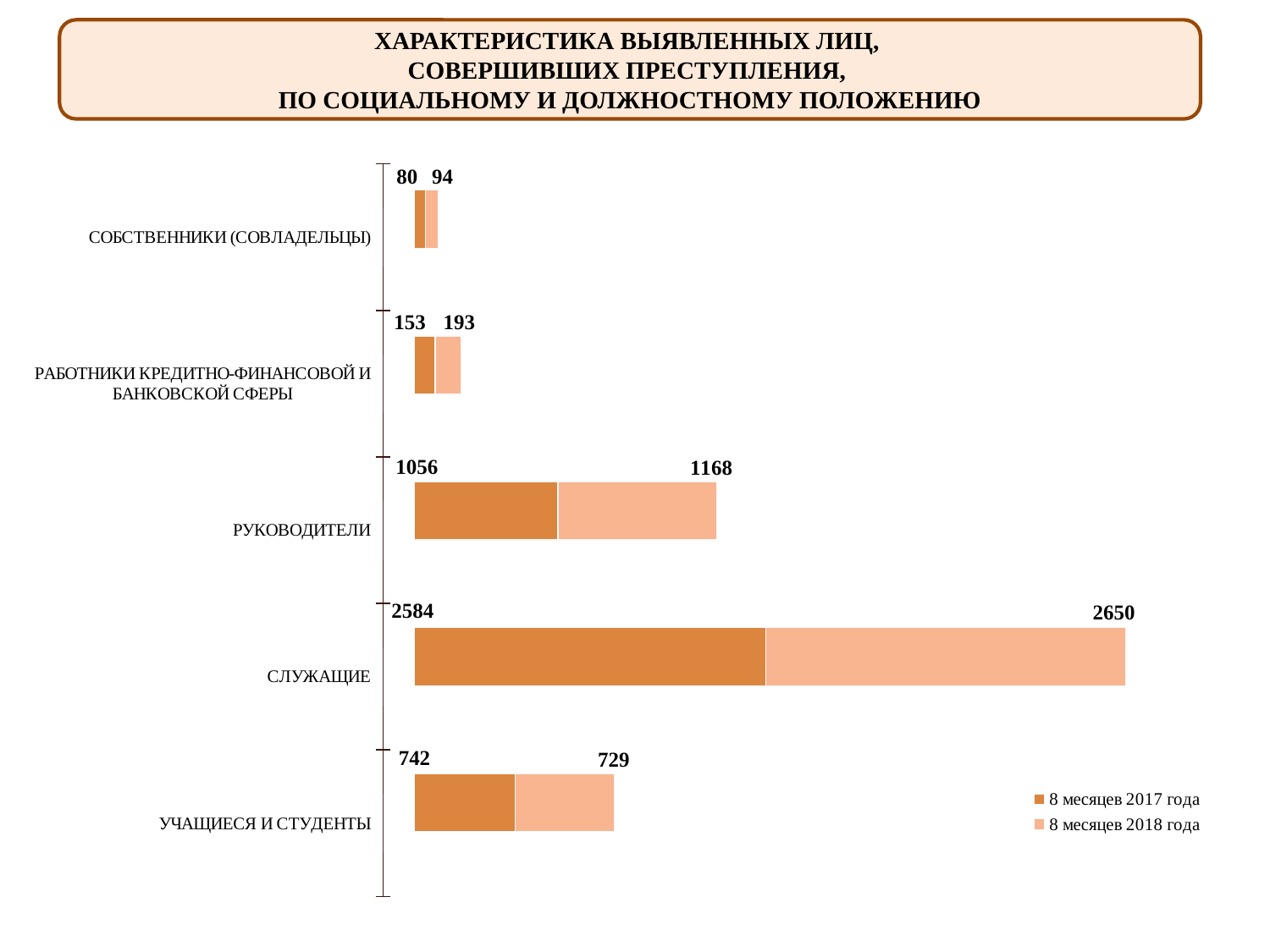
What type of chart is shown on the slide? Stacked bar chart What is the value for СЛУЖАЩИЕ in the series 8 месяцев 2018 года? 2650 Which series is shown in the darker orange colour? 8 месяцев 2017 года What is the difference between the 8 месяцев 2018 года and 8 месяцев 2017 года values for РАБОТНИКИ КРЕДИТНО-ФИНАНСОВОЙ И БАНКОВСКОЙ СФЕРЫ? 40 What is the total of the stacked bar for РУКОВОДИТЕЛИ? 2224 How many series does the legend list? 2 For УЧАЩИЕСЯ И СТУДЕНТЫ, which series has the larger value: 8 месяцев 2017 года or 8 месяцев 2018 года? 8 месяцев 2017 года Which category has the highest value in the series 8 месяцев 2017 года? СЛУЖАЩИЕ Which category has the lowest value in the series 8 месяцев 2018 года? СОБСТВЕННИКИ (СОВЛАДЕЛЬЦЫ) How many categories are shown on the chart? 5 What is the value for РУКОВОДИТЕЛИ in the series 8 месяцев 2017 года? 1056 What is the value for СОБСТВЕННИКИ (СОВЛАДЕЛЬЦЫ) in the series 8 месяцев 2018 года? 94